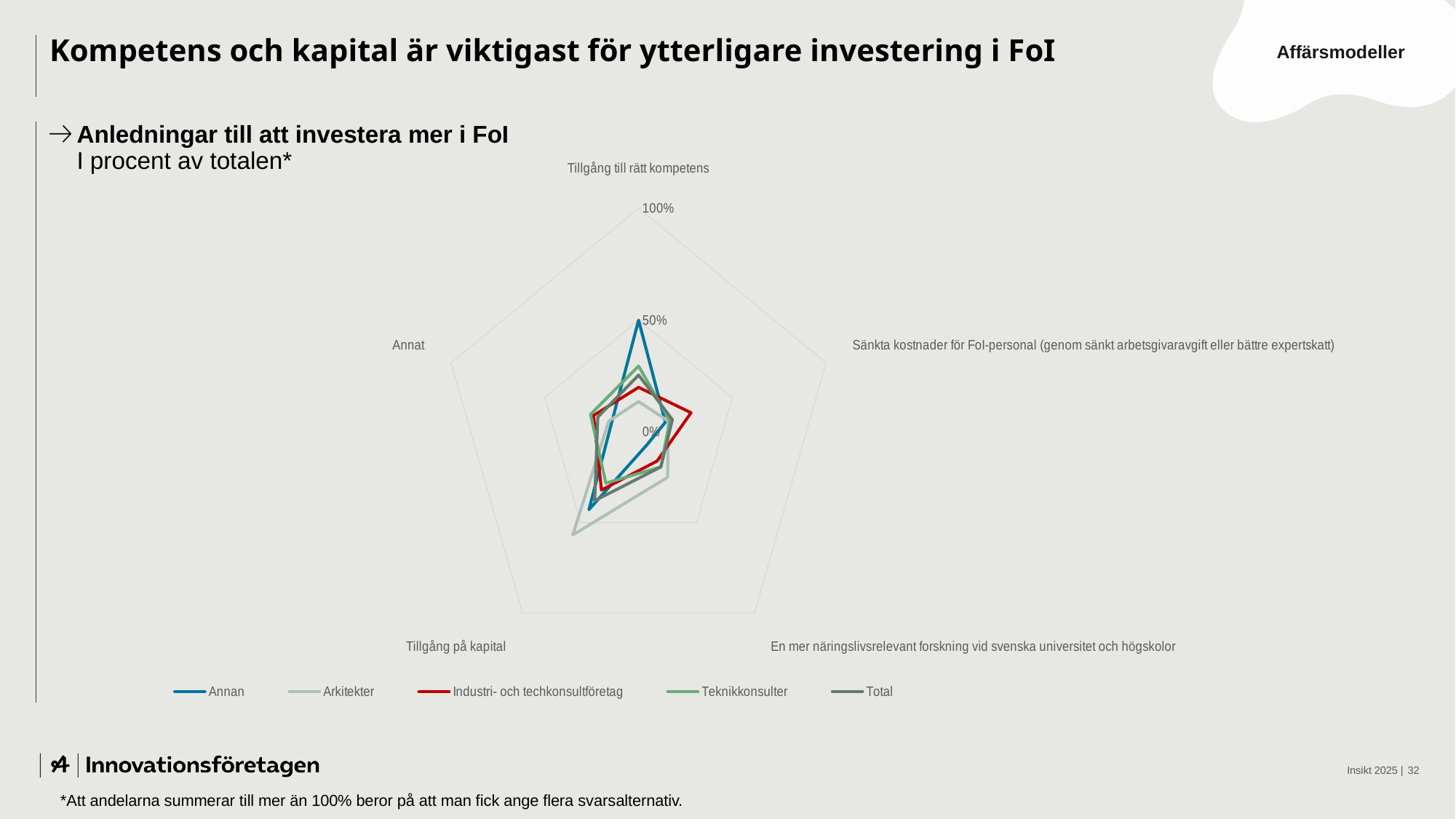
Which series has the highest value for 'Tillgång till rätt kompetens'? Annan What is the title of the chart? Anledningar till att investera mer i FoI Is the value for Total on 'Tillgång till rätt kompetens' greater or less than 50%? less What kind of chart is shown on the slide? Radar chart How many series does the legend list? 5 Which colour represents the Industri- och techkonsultföretag series in the legend? Red For the Arkitekter series, which category has the highest value? Tillgång på kapital Which series has the highest value for 'Tillgång på kapital'? Arkitekter Is the value for Annan on 'Annat' greater or less than 50%? less How many categories (axes) does the radar chart have? 5 Is the value for Industri- och techkonsultföretag on 'Sänkta kostnader för FoI-personal' greater or less than 50%? less